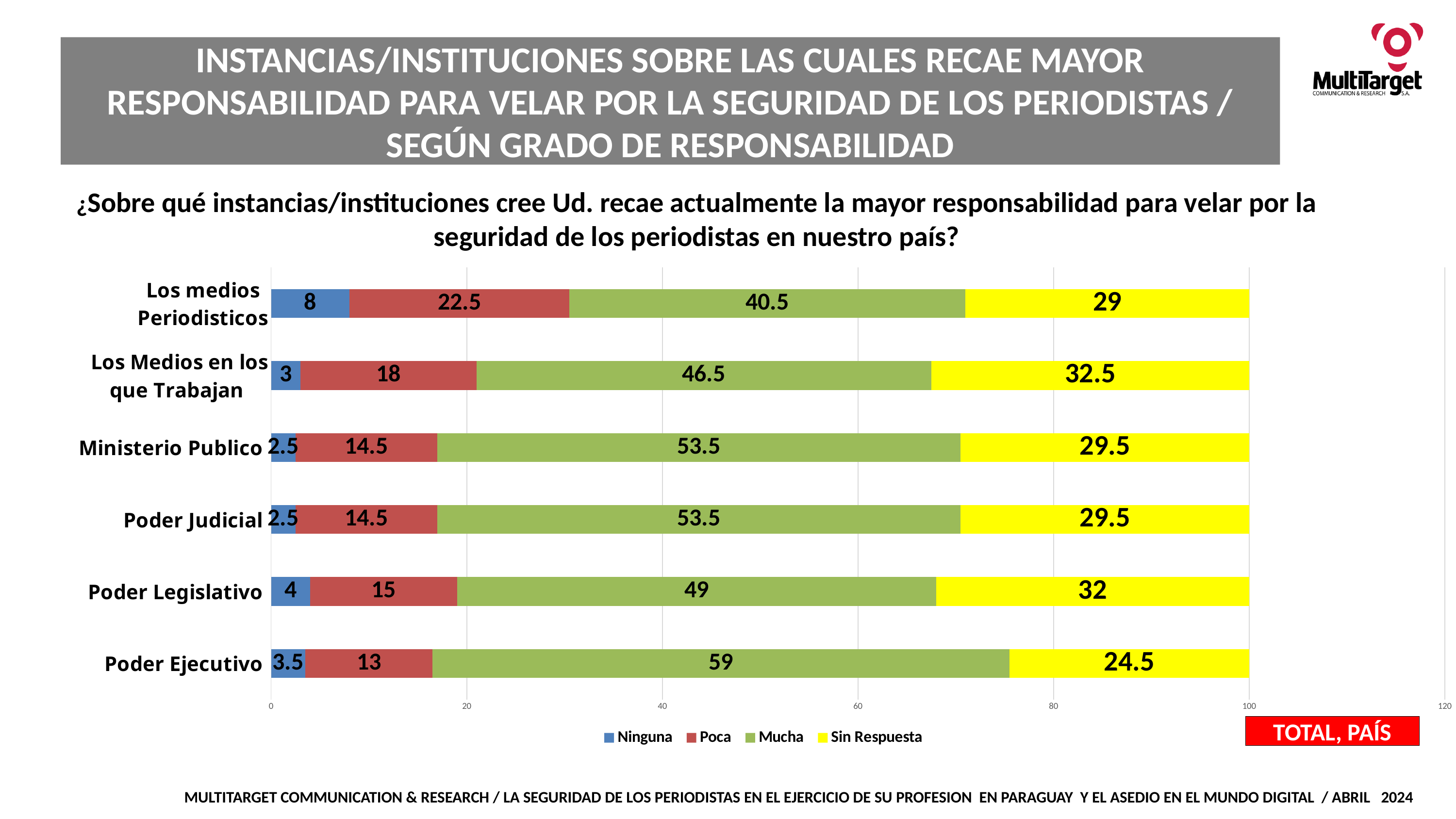
Which category has the highest "Mucha" value? Poder Ejecutivo Which category has the lowest "Mucha" value? Los medios Periodisticos What kind of chart is shown on the slide? Stacked bar chart What is the difference between the "Mucha" values for Poder Ejecutivo and Los medios Periodisticos? 18.5 What is the total of the stacked bar for Poder Ejecutivo? 100 What is the value of "Mucha" for Poder Ejecutivo? 59 How many categories (institutions) are shown in the chart? 6 What is the value of "Sin Respuesta" for Los Medios en los que Trabajan? 32.5 What is the value of "Ninguna" for Los medios Periodisticos? 8 How many series does the legend list? 4 What is the value of "Poca" for Poder Legislativo? 15 Which is larger: the "Poca" value for Los medios Periodisticos or for Los Medios en los que Trabajan? Los medios Periodisticos